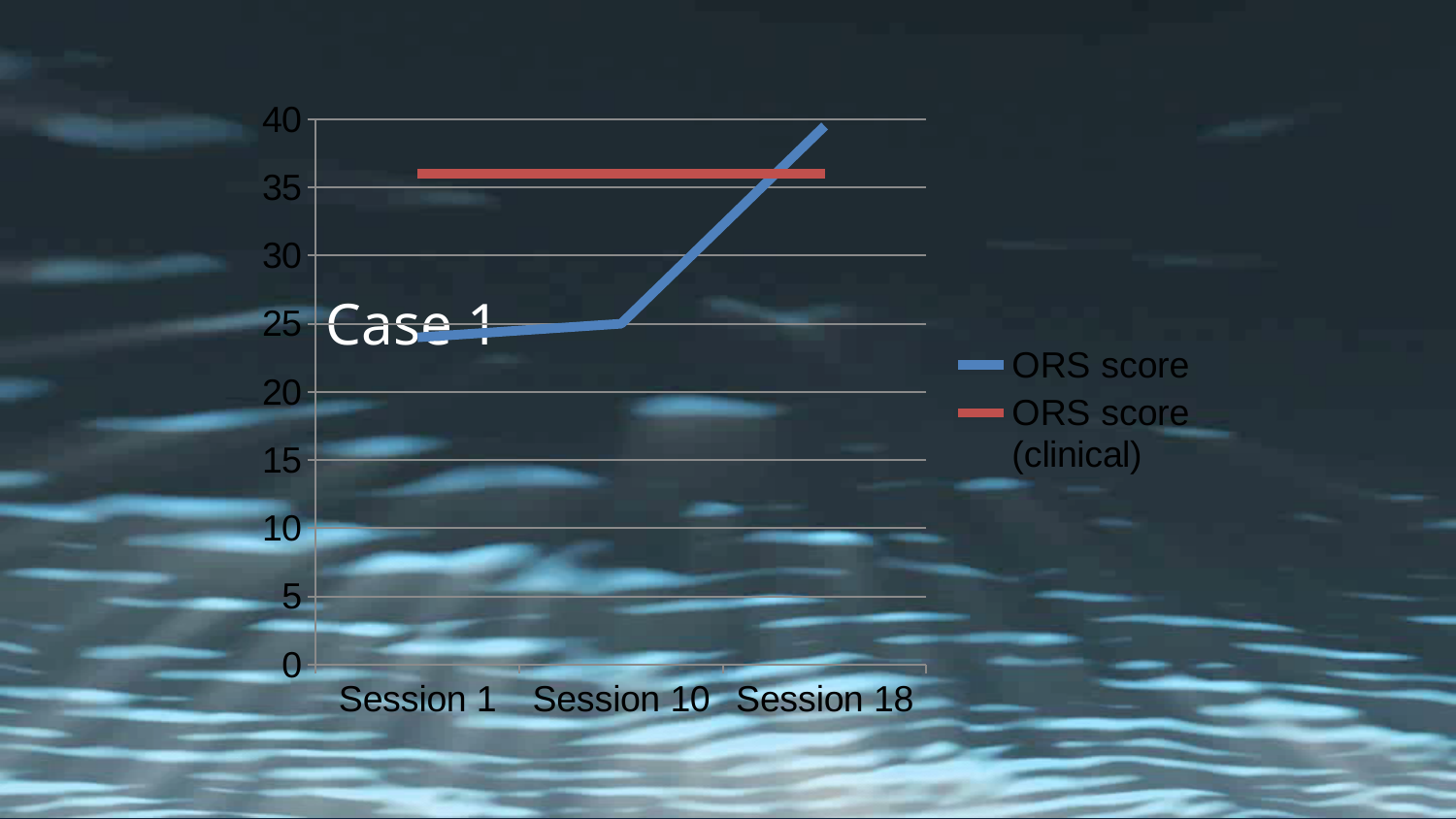
Is the ORS score at Session 18 greater or less than 35? greater Does the ORS score rise or fall from Session 1 to Session 18? rise Is the ORS score at Session 10 greater or less than 30? less How many sessions are plotted along the x axis? 3 Is the ORS score (clinical) line greater or less than 40? less Which is larger at Session 1: the ORS score or the ORS score (clinical)? ORS score (clinical) What kind of chart is shown on the slide? line chart Which is larger at Session 18: the ORS score or the ORS score (clinical)? ORS score What is the title of the chart? Case 1 At which session is the ORS score highest? Session 18 How many series does the legend list? 2